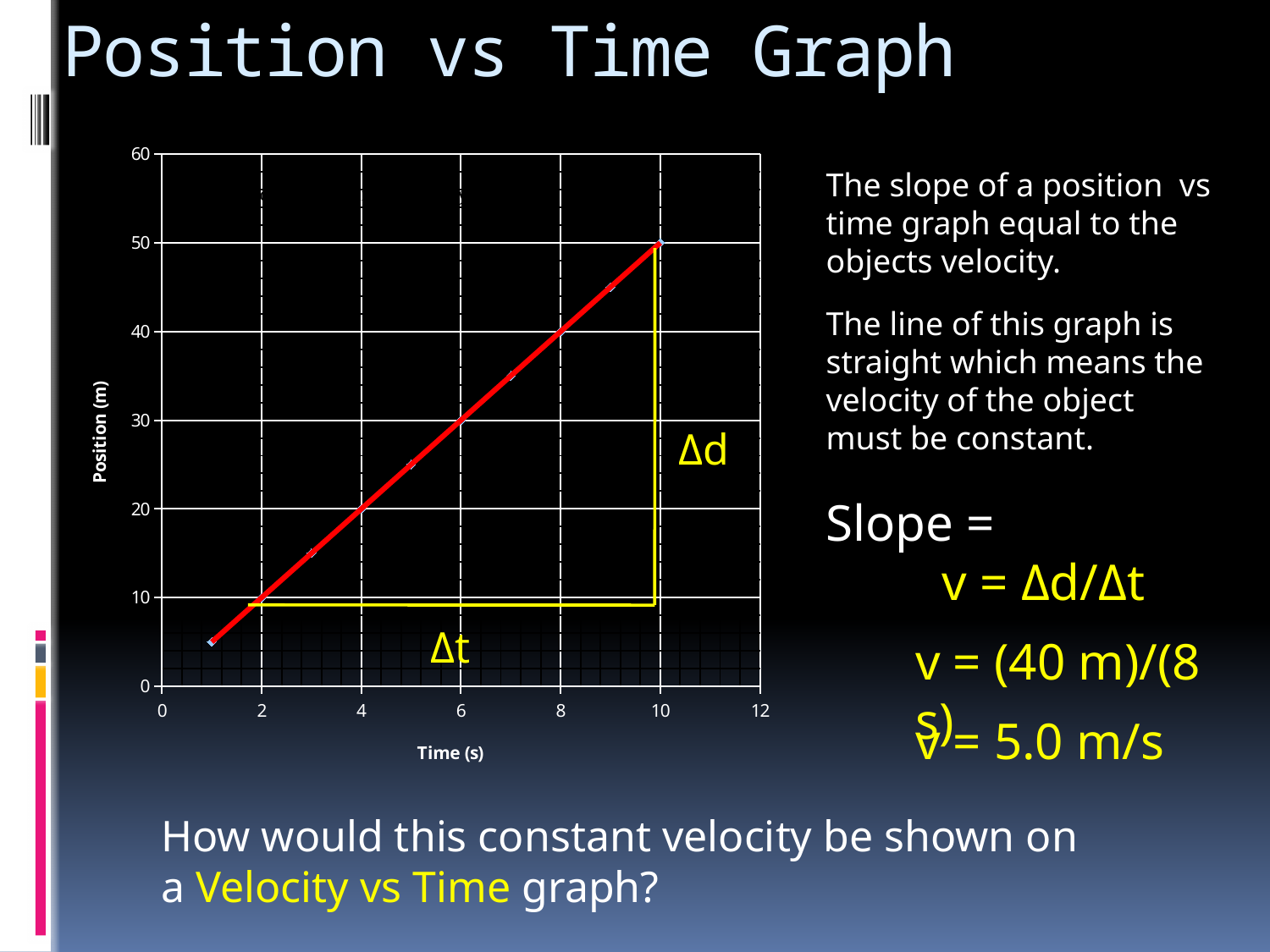
Which is larger, the position at 8 s or the position at 4 s? position at 8 s What is the position at a time of 10 s? 50 What type of chart is shown on the slide? line chart What is the position at a time of 6 s? 30 What is the difference between the position at 10 s and the position at 2 s? 40 What is the position at a time of 2 s? 10 Is the position at a time of 5 s greater or less than 20? greater Does the position rise or fall as time increases along the x axis? rises Is the position at a time of 3 s greater or less than 20? less What is the label of the vertical axis of the chart? Position (m) What is the label of the horizontal axis of the chart? Time (s) What is the position at a time of 4 s? 20